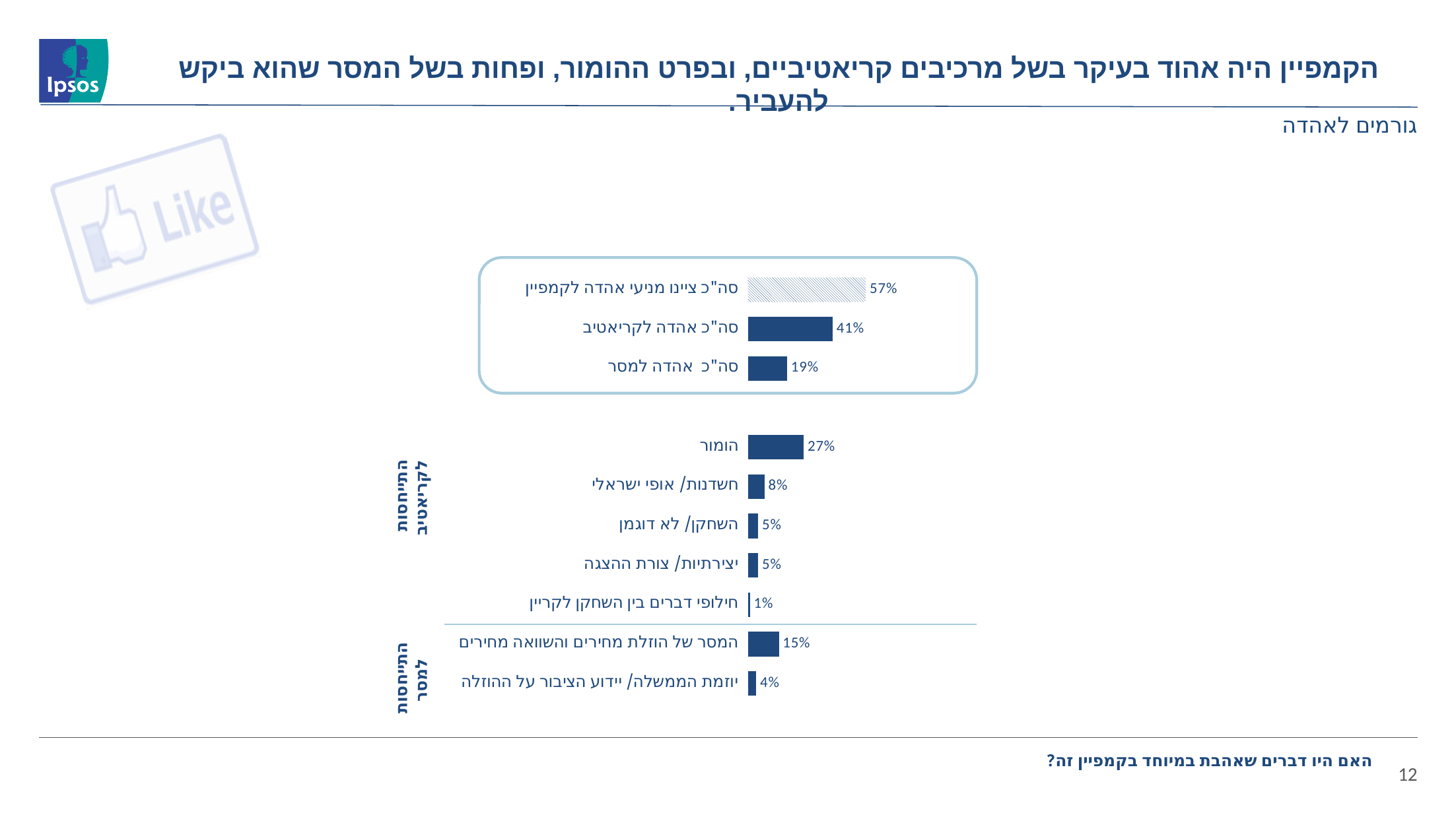
What is the value for הומור? 27% What is the value for סה"כ אהדה למסר? 19% What is the difference between the values for סה"כ אהדה לקריאטיב and סה"כ אהדה למסר? 22% What is the value for המסר של הוזלת מחירים והשוואה מחירים? 15% How many bars are plotted in the chart? 10 What is the value for סה"כ ציינו מניעי אהדה לקמפיין? 57% Which category has the lowest value in the chart? חילופי דברים בין השחקן לקריין What is the value for סה"כ אהדה לקריאטיב? 41% What kind of chart is shown on the slide? bar chart Which category has the highest value in the chart? סה"כ ציינו מניעי אהדה לקמפיין What is the value for יוזמת הממשלה/ יידוע הציבור על ההוזלה? 4% Which is larger, the value for הומור or the value for המסר של הוזלת מחירים והשוואה מחירים? הומור